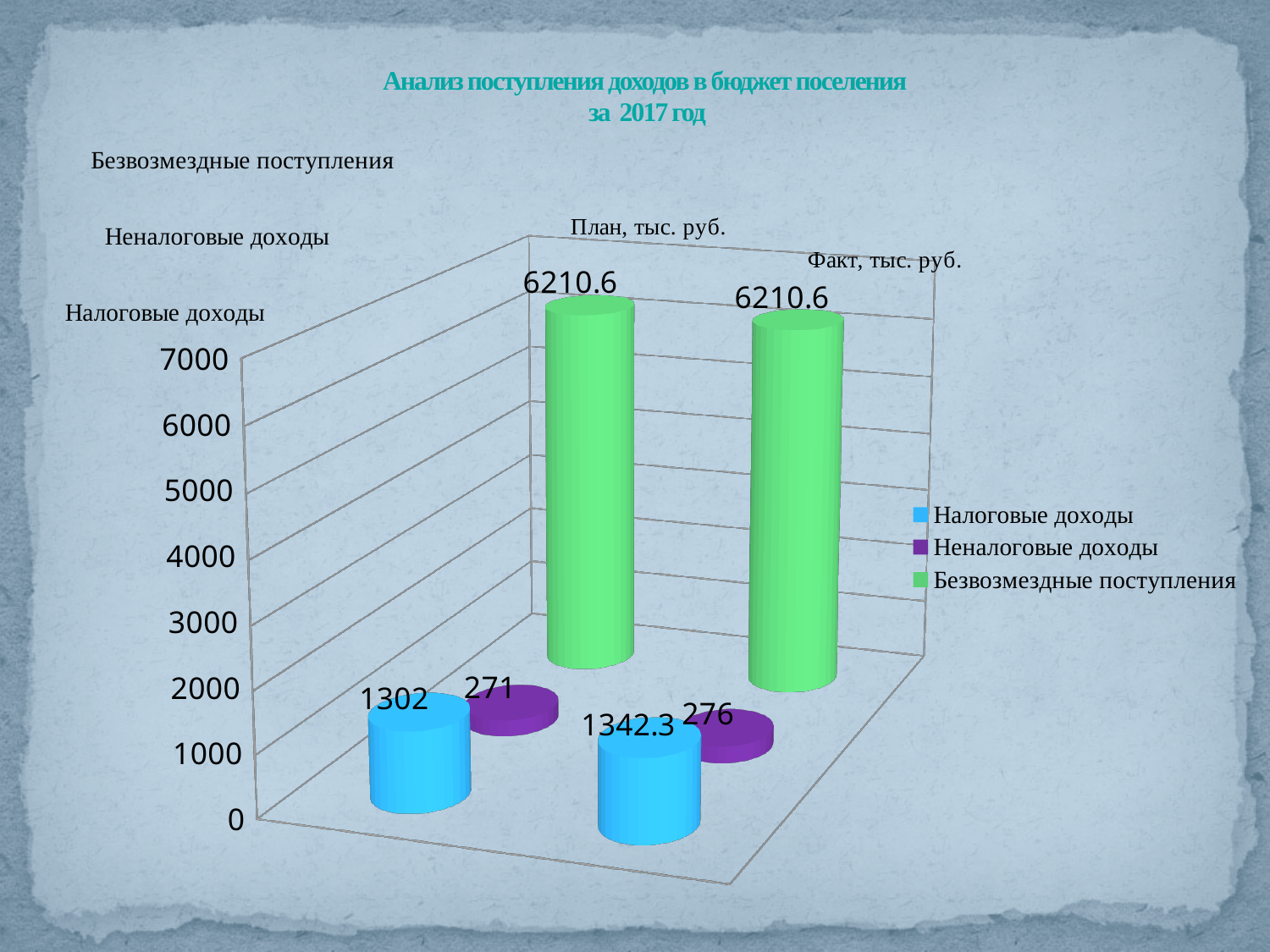
What is the value of Налоговые доходы for План, тыс. руб.? 1302 How many series does the legend list? 3 What is the value of Неналоговые доходы for Факт, тыс. руб.? 276 What is the difference between the Факт and План values for Налоговые доходы? 40.3 What colour represents Безвозмездные поступления in the chart? Green What kind of chart is shown on the slide? Bar chart What is the value of Неналоговые доходы for План, тыс. руб.? 271 What is the value of Налоговые доходы for Факт, тыс. руб.? 1342.3 Which is larger: Неналоговые доходы for План or for Факт? Факт Which series has the highest value for План, тыс. руб.? Безвозмездные поступления Which series has the lowest value for Факт, тыс. руб.? Неналоговые доходы What is the value of Безвозмездные поступления for Факт, тыс. руб.? 6210.6